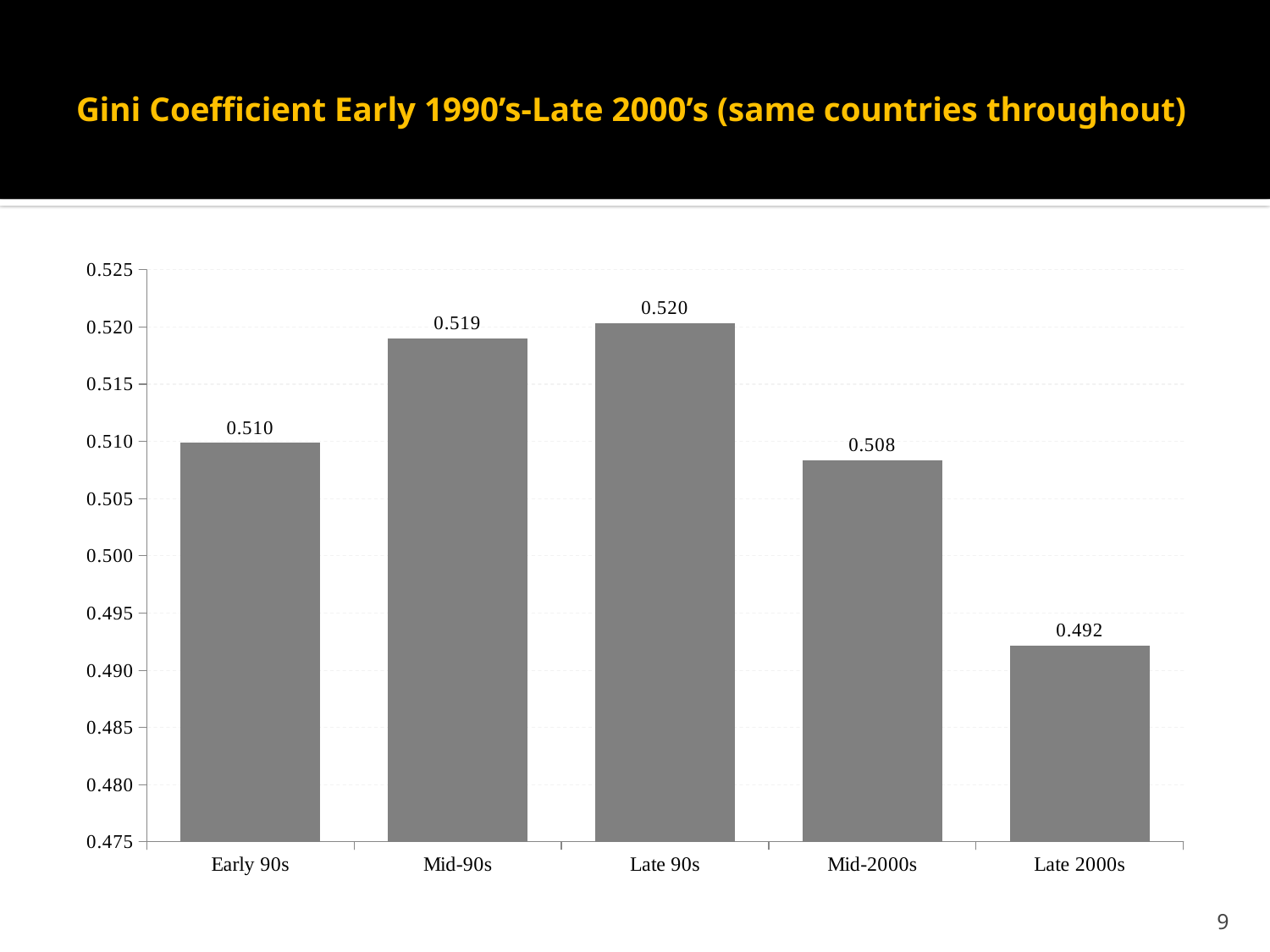
Which period has the highest Gini coefficient? Late 90s What kind of chart is shown on the slide? bar chart What is the difference between the Gini coefficient for Mid-90s and Early 90s? 0.009 How many periods are shown on the x axis? 5 Do the values rise or fall from Late 90s to Late 2000s? fall Is the value for Late 2000s greater or less than 0.500? less What is the Gini coefficient value for Late 2000s? 0.492 Which is larger, the Gini coefficient for Early 90s or Mid-2000s? Early 90s What is the difference between the Gini coefficient for Late 90s and Late 2000s? 0.028 What is the Gini coefficient value for Early 90s? 0.510 Which period has the lowest Gini coefficient? Late 2000s What is the Gini coefficient value for Mid-2000s? 0.508